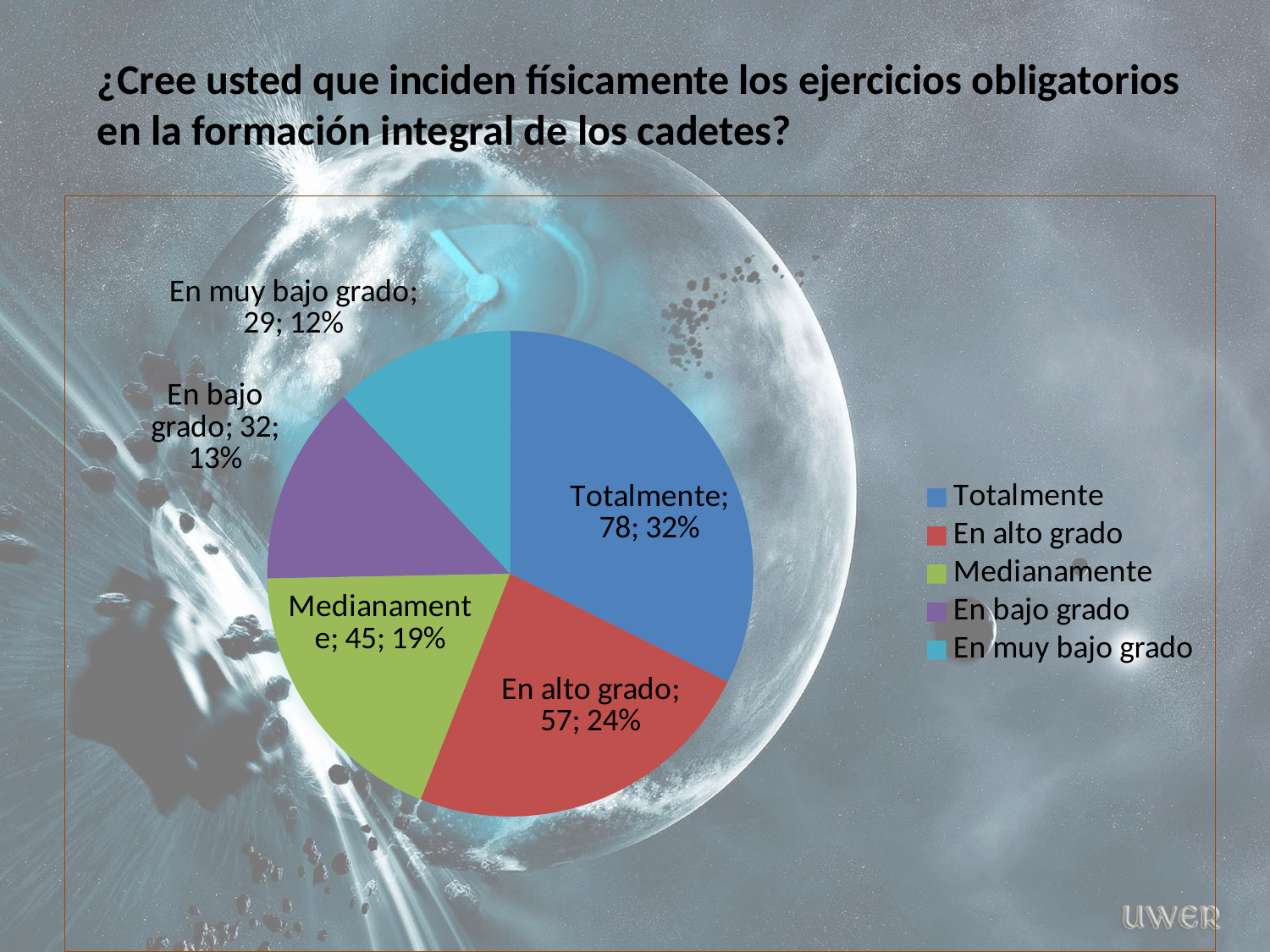
What percentage of the pie does "En alto grado" represent? 24% What is the difference in respondents between "Totalmente" and "En alto grado"? 21 How many respondents answered "Medianamente"? 45 What is the total number of respondents across all slices? 241 What colour is the "Medianamente" slice? green What percentage share does "En muy bajo grado" have? 12% How many categories does the pie chart have? 5 Which category has the largest slice of the pie? Totalmente Which has more respondents, "En bajo grado" or "En muy bajo grado"? En bajo grado What type of chart is shown on the slide? pie chart Which category has the smallest slice of the pie? En muy bajo grado How many respondents answered "Totalmente"? 78